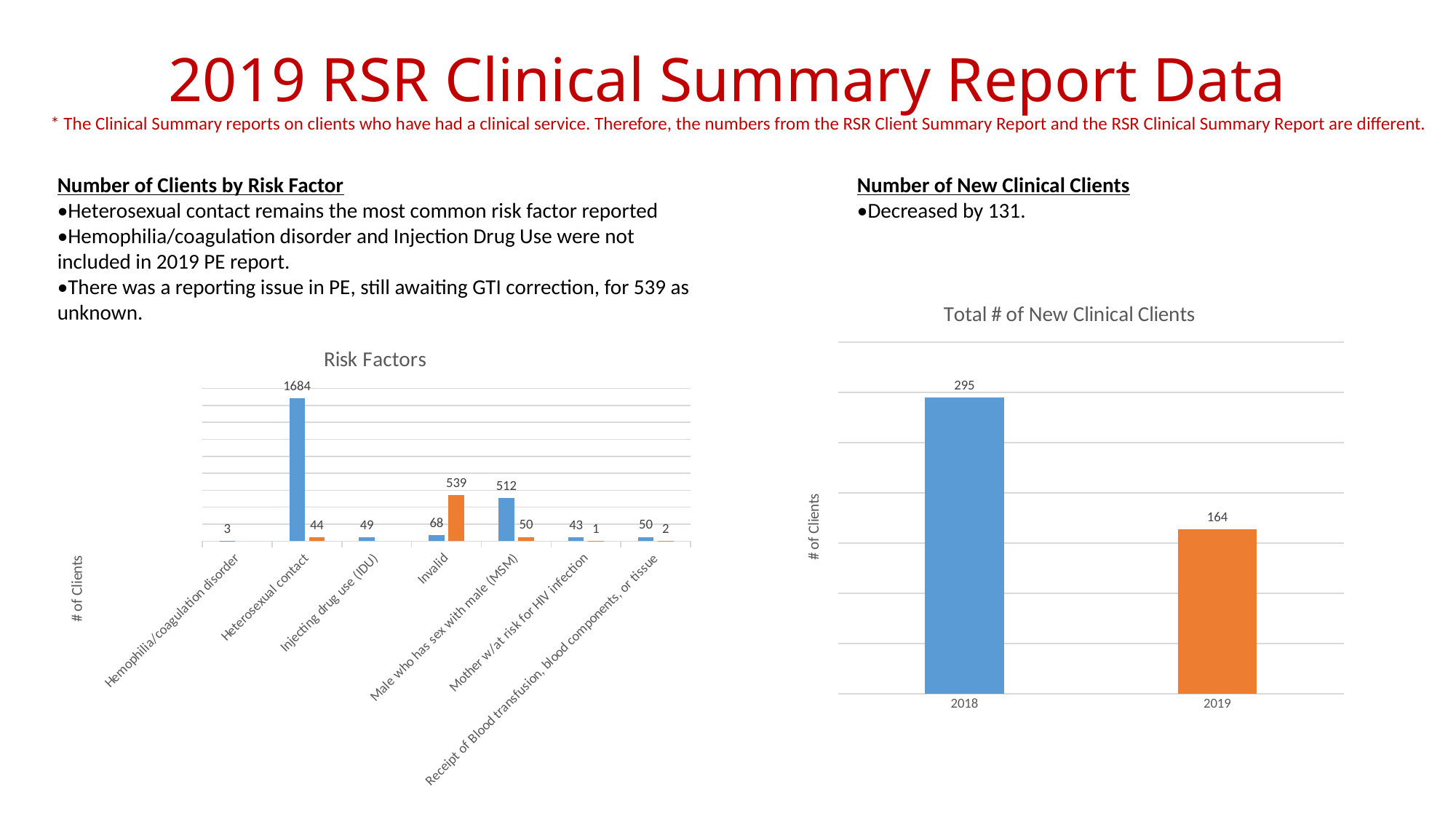
In the 'Risk Factors' chart, which is larger: the blue bar for Injecting drug use (IDU) or the blue bar for Mother w/at risk for HIV infection? Injecting drug use (IDU) In the 'Total # of New Clinical Clients' chart, do the values rise or fall from 2018 to 2019? fall In the 'Risk Factors' chart, what is the value of the blue bar for Heterosexual contact? 1684 In the 'Risk Factors' chart, what is the value of the orange bar for Invalid? 539 In the 'Total # of New Clinical Clients' chart, what is the difference between the 2018 and 2019 values? 131 What is the y-axis label of the 'Risk Factors' chart? # of Clients In the 'Risk Factors' chart, how many categories are shown on the x axis? 7 In the 'Risk Factors' chart, which category has the highest blue bar? Heterosexual contact What kind of chart is the 'Total # of New Clinical Clients' chart? bar chart In the 'Risk Factors' chart, what is the value of the blue bar for Male who has sex with male (MSM)? 512 In the 'Total # of New Clinical Clients' chart, what is the value for 2018? 295 In the 'Total # of New Clinical Clients' chart, what is the value for 2019? 164